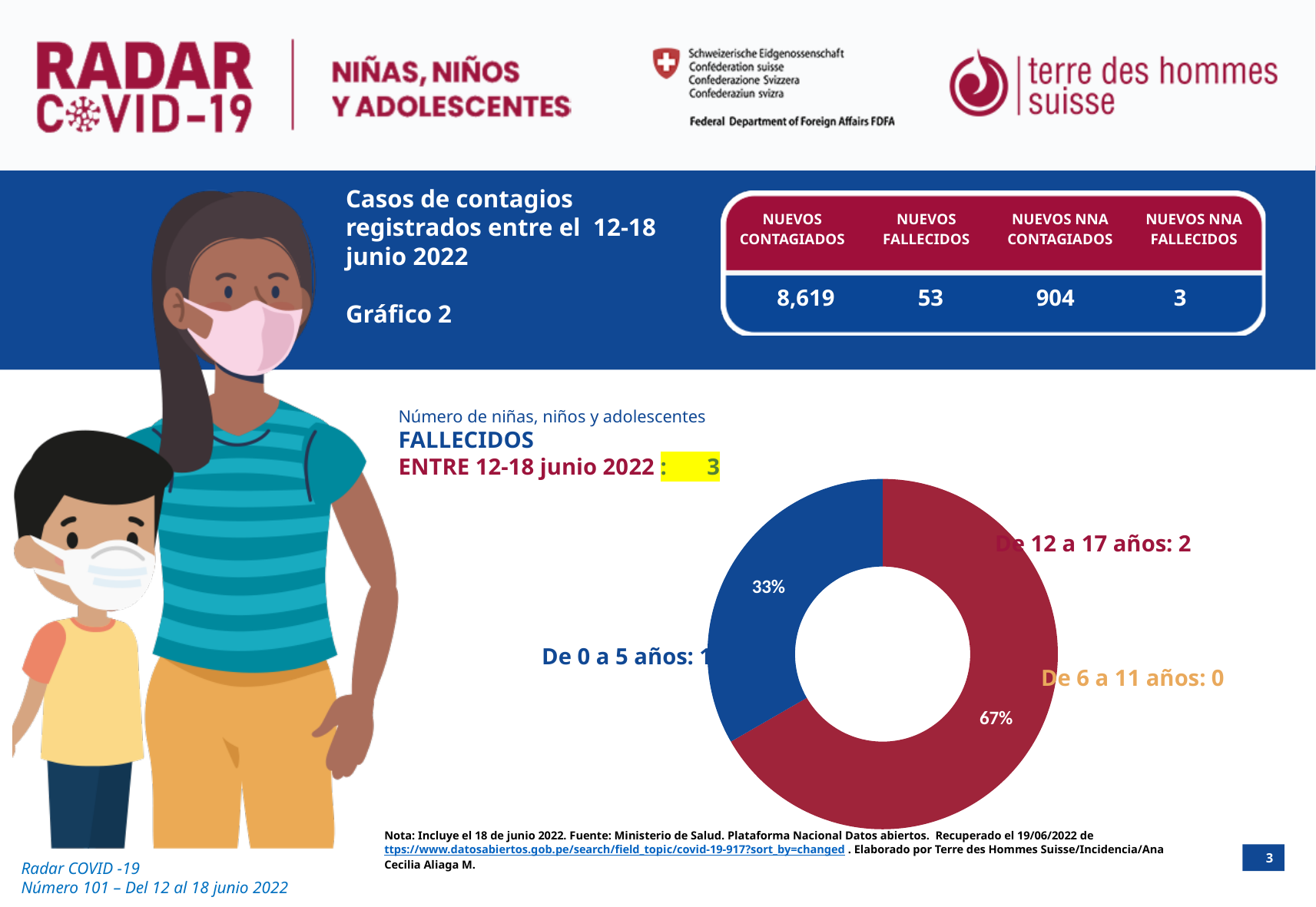
What is the number of deaths for the category 'De 12 a 17 años'? 2 What is the difference in deaths between 'De 12 a 17 años' and 'De 0 a 5 años'? 1 What colour is the slice for 'De 12 a 17 años' in the donut chart? Red What is the number of deaths for the category 'De 6 a 11 años'? 0 Which age category has the highest number of deaths in the donut chart? De 12 a 17 años How many age categories does the donut chart show? 3 What kind of chart is shown on the slide? Donut (pie) chart What percentage share of the donut chart does 'De 12 a 17 años' represent? 67% What is the total number of deaths shown across all categories in the donut chart? 3 What percentage share of the donut chart does 'De 0 a 5 años' represent? 33% Which age category has the lowest number of deaths in the donut chart? De 6 a 11 años What is the number of deaths for the category 'De 0 a 5 años'? 1